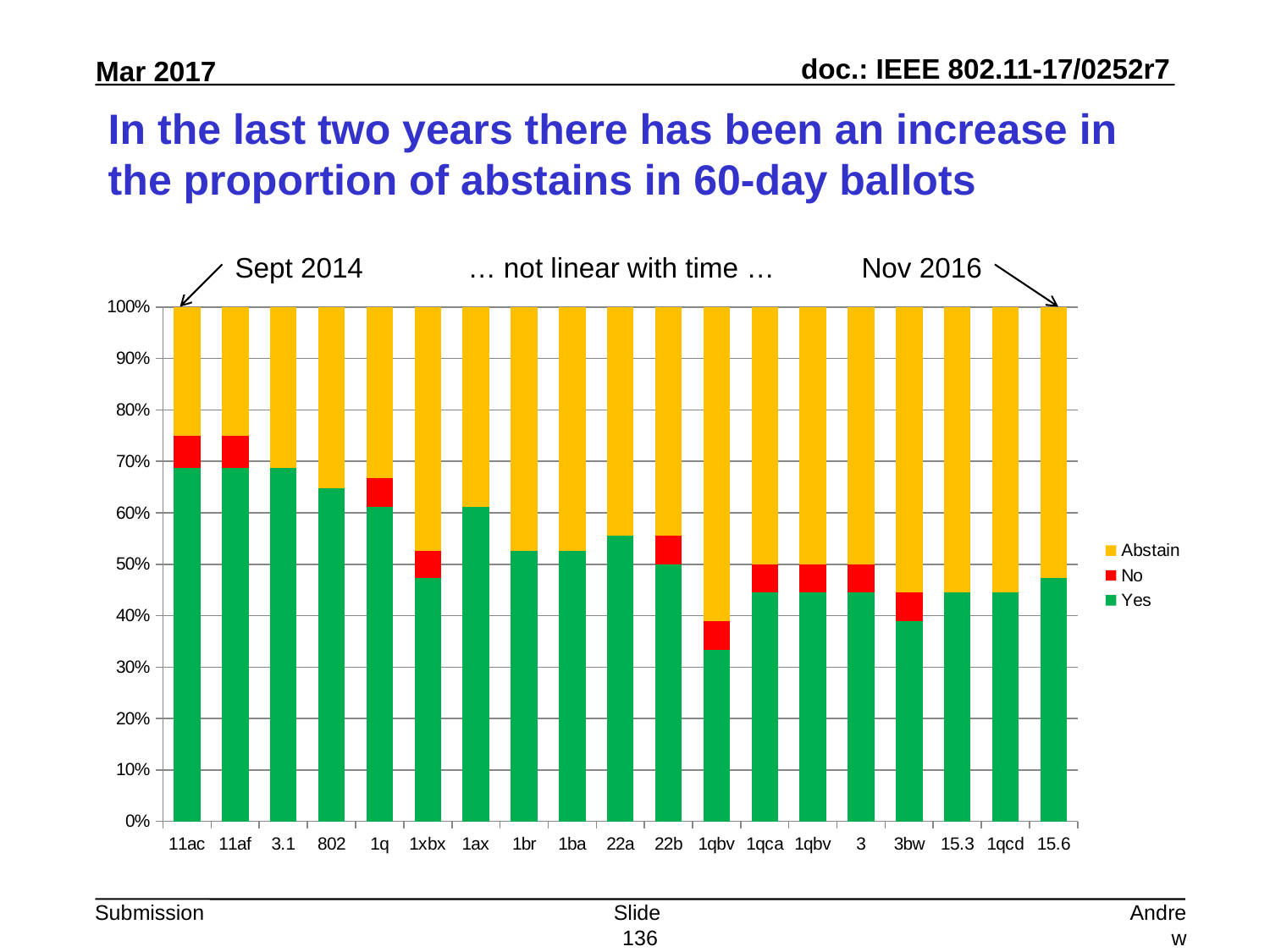
What kind of chart is shown on the slide? stacked bar chart Is the Yes value for 1xbx greater or less than 50%? less What are the three entries in the legend? Abstain, No, Yes Which category has the lowest Yes proportion? 1qbv Does the Abstain share generally rise or fall from left to right along the x axis? rise Is the Yes value for 15.6 greater or less than 50%? less Is the Yes value for 11ac greater or less than 60%? greater Which has the larger Yes proportion, 802 or 15.6? 802 How many ballot categories are shown along the x axis? 19 What colour represents the Abstain series? yellow How many series does the legend list? 3 What is the total of the stacked bar for 11ac? 100%